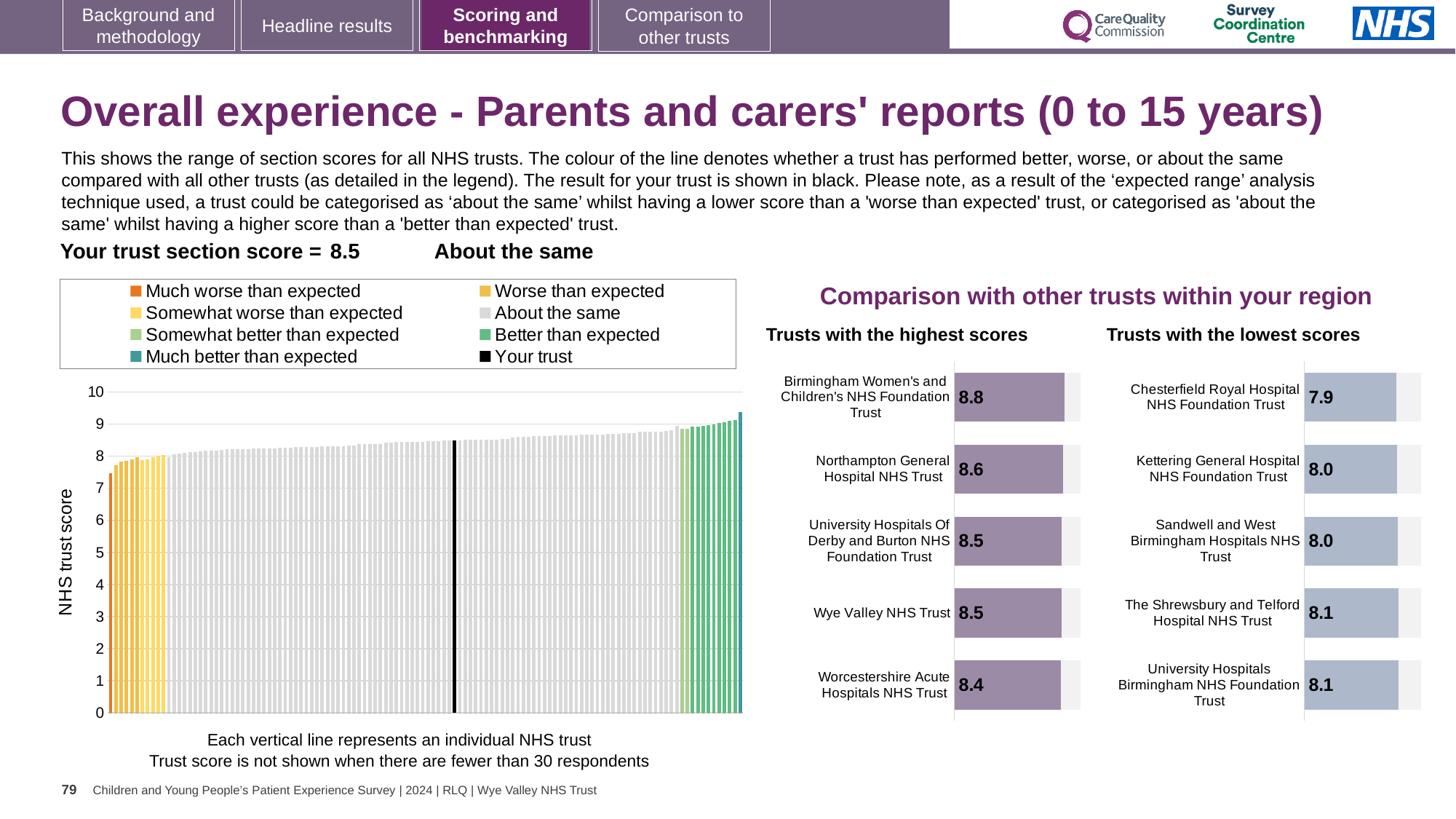
In the 'Trusts with the highest scores' chart, which trust has the lowest score? Worcestershire Acute Hospitals NHS Trust In the 'Trusts with the highest scores' chart, what is the difference between the scores of Birmingham Women's and Children's NHS Foundation Trust and Worcestershire Acute Hospitals NHS Trust? 0.4 In the 'Trusts with the lowest scores' chart, what is the score for Chesterfield Royal Hospital NHS Foundation Trust? 7.9 What kind of chart is the large chart on the left showing all NHS trusts? Bar chart In the 'Trusts with the lowest scores' chart, what is the score for University Hospitals Birmingham NHS Foundation Trust? 8.1 How many entries does the legend of the large chart on the left list? 8 In the 'Trusts with the lowest scores' chart, which is larger: the score for Kettering General Hospital NHS Foundation Trust or Chesterfield Royal Hospital NHS Foundation Trust? Kettering General Hospital NHS Foundation Trust In the 'Trusts with the highest scores' chart, how many trusts are shown? 5 In the 'Trusts with the lowest scores' chart, what is the difference between the scores of The Shrewsbury and Telford Hospital NHS Trust and Chesterfield Royal Hospital NHS Foundation Trust? 0.2 In the large chart on the left, is the value for the highest-scoring trust (the rightmost bar) greater or less than 9? greater In the 'Trusts with the lowest scores' chart, which trust has the lowest score? Chesterfield Royal Hospital NHS Foundation Trust In the 'Trusts with the highest scores' chart, what is the score for Birmingham Women's and Children's NHS Foundation Trust? 8.8